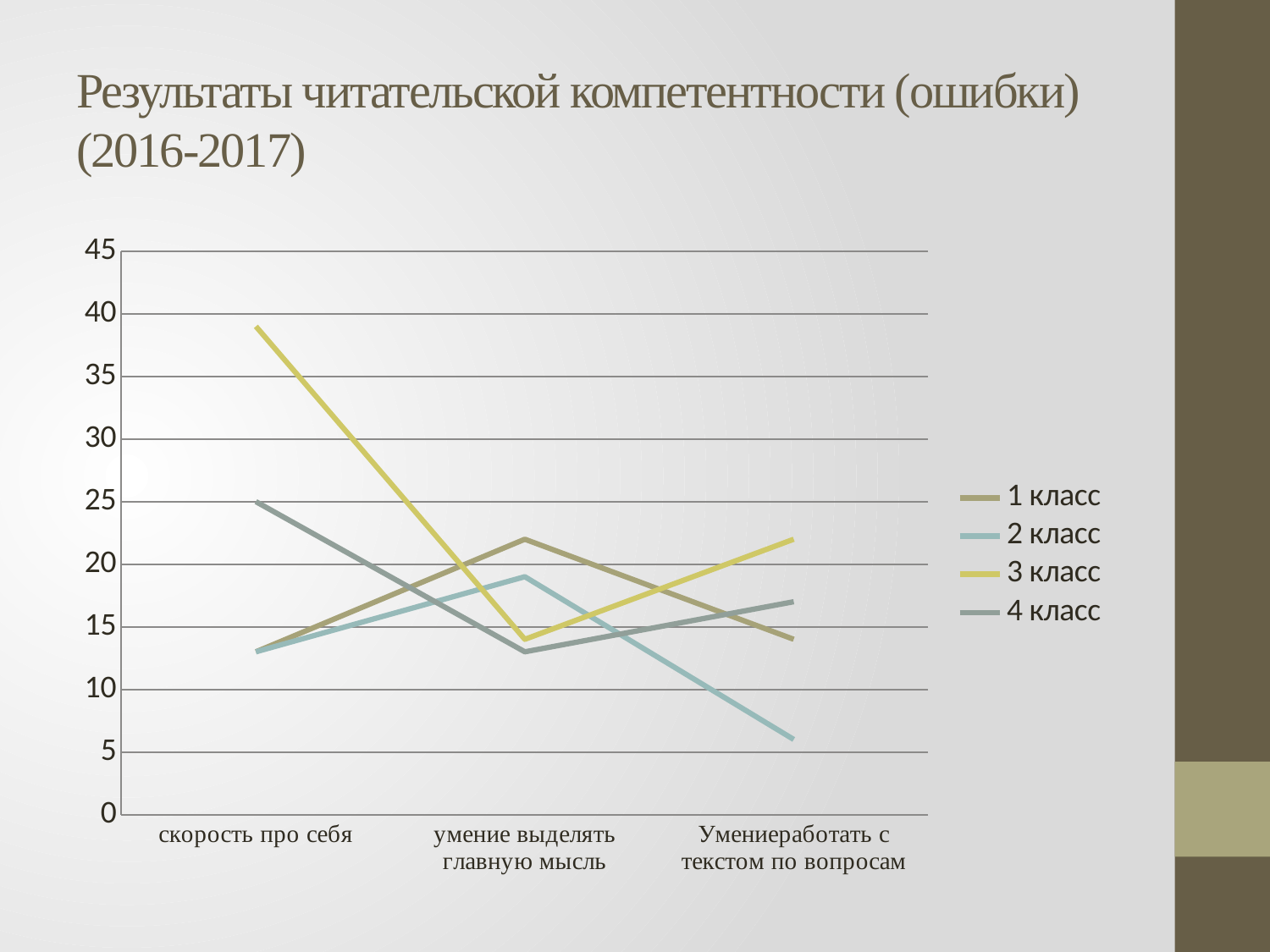
What kind of chart is shown on the slide? line chart Is the value for 1 класс at "умение выделять главную мысль" greater or less than 20? greater How many series does the legend list? 4 Which series has the highest value at "скорость про себя"? 3 класс Which series has the lowest value at "Умениеработать с текстом по вопросам"? 2 класс How many categories are shown on the x axis? 3 Is the value for 2 класс at "Умениеработать с текстом по вопросам" greater or less than 10? less Is the value for 3 класс at "скорость про себя" greater or less than 35? greater What is the value for 4 класс at "скорость про себя"? 25 What is the title of the slide containing the chart? Результаты читательской компетентности (ошибки) (2016-2017) Does the 3 класс line rise or fall from "скорость про себя" to "умение выделять главную мысль"? fall At "скорость про себя", which is larger: the value for 3 класс or the value for 4 класс? 3 класс